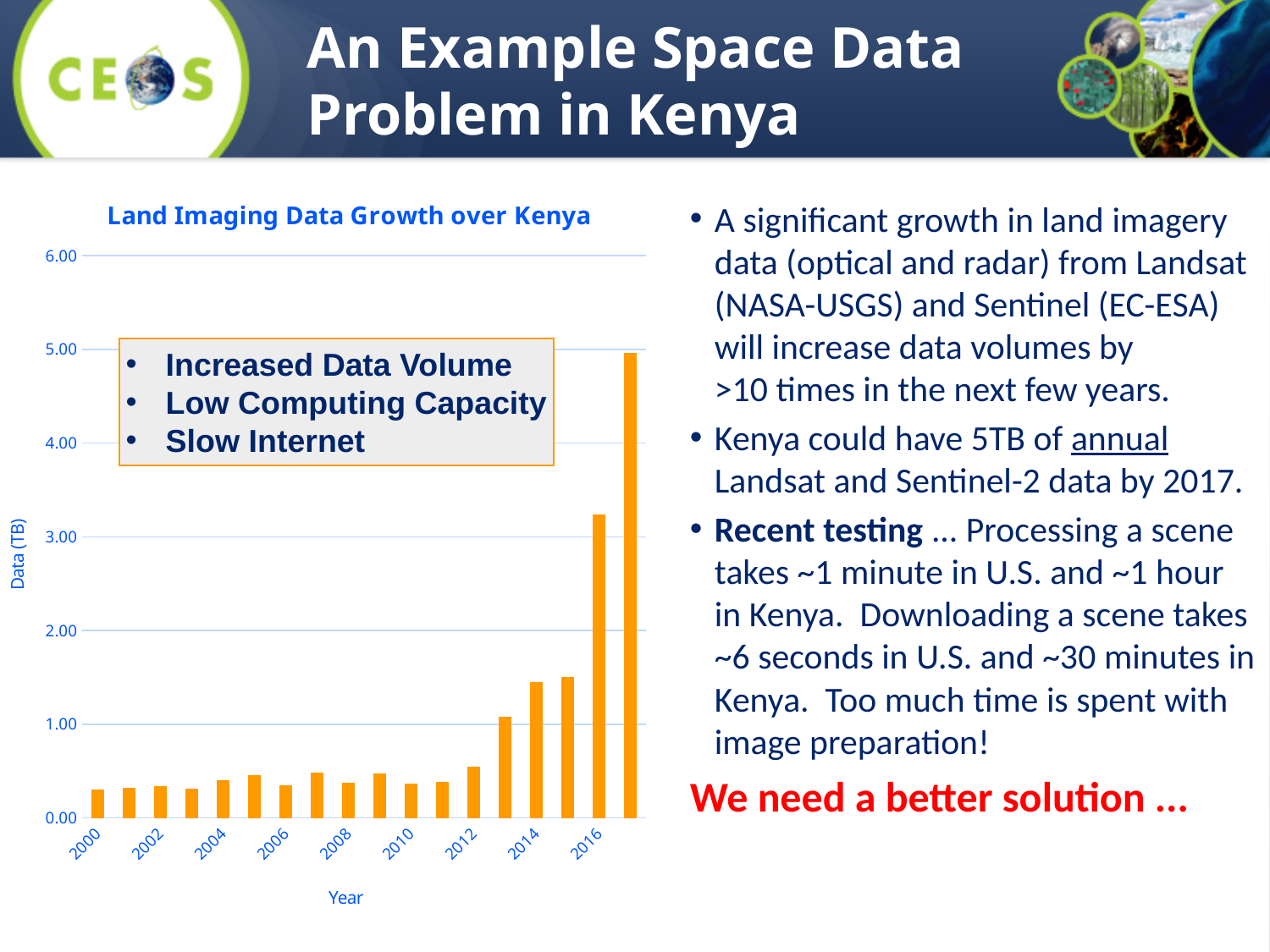
Is the value for 2016 greater or less than 4.00? less Which has the larger value, 2014 or 2016? 2016 Which has the larger value, 2010 or 2014? 2014 Do the values generally rise or fall from 2000 to the last year shown? rise Is the value for 2014 greater or less than 1.00? greater What is the label of the vertical axis of the chart? Data (TB) How many bars are plotted in the chart? 18 What is the title of the chart? Land Imaging Data Growth over Kenya Is the value for 2000 greater or less than 1.00? less What kind of chart is shown on the slide? bar chart